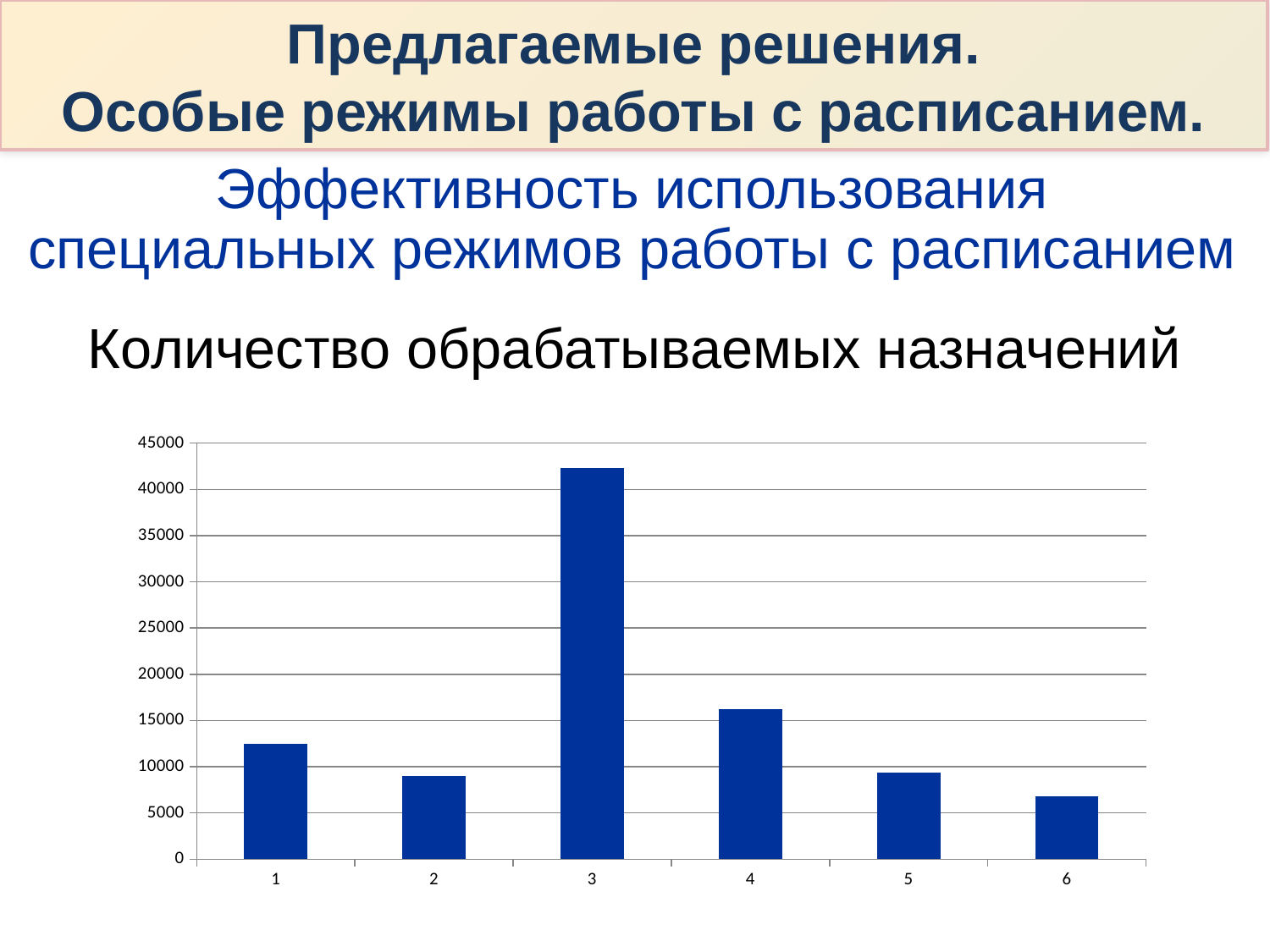
What kind of chart is shown on the slide? bar chart Which category has the highest value in the chart? 3 Which category has the lowest value in the chart? 6 Is the value for category 1 greater or less than 10000? greater Is the value for category 4 greater or less than 20000? less How many categories are plotted on the x axis of the chart? 6 Is the value for category 2 greater or less than 5000? greater Which is larger, the value for category 4 or the value for category 5? category 4 Which is larger, the value for category 1 or the value for category 2? category 1 What is the heading shown directly above the chart? Количество обрабатываемых назначений